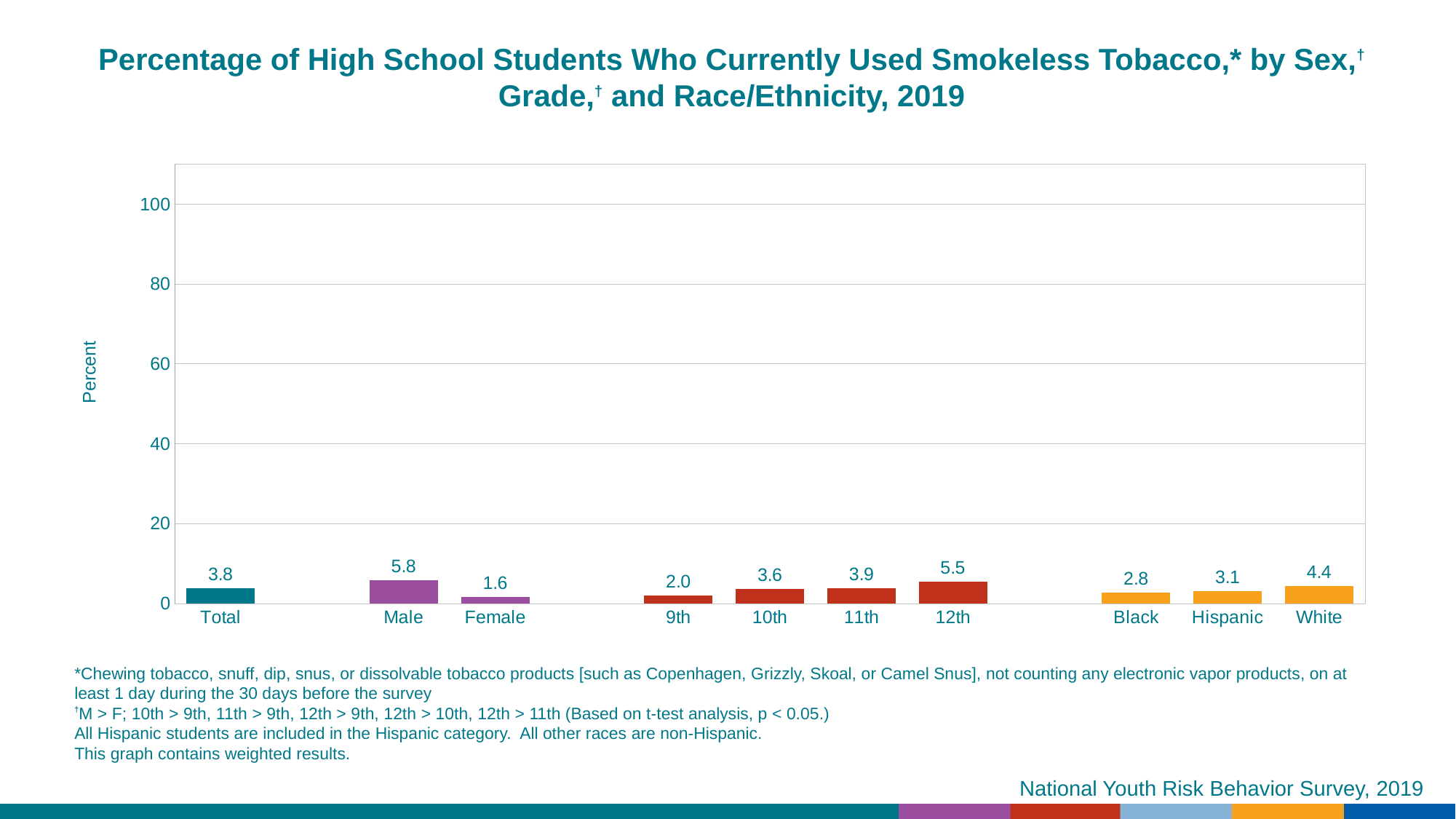
Is the value for Total greater or less than 20? less Which category has the lowest value? Female Which is larger, the value for White or the value for Black? White What kind of chart is this? bar chart What is the value for 12th grade? 5.5 What is the value for Hispanic students? 3.1 How many categories are shown on the x axis? 10 What is the difference between the values for Male and Female? 4.2 Which category has the highest value? Male What is the label of the y axis? Percent Do the values rise or fall from 9th grade to 12th grade? rise What is the value for Male? 5.8